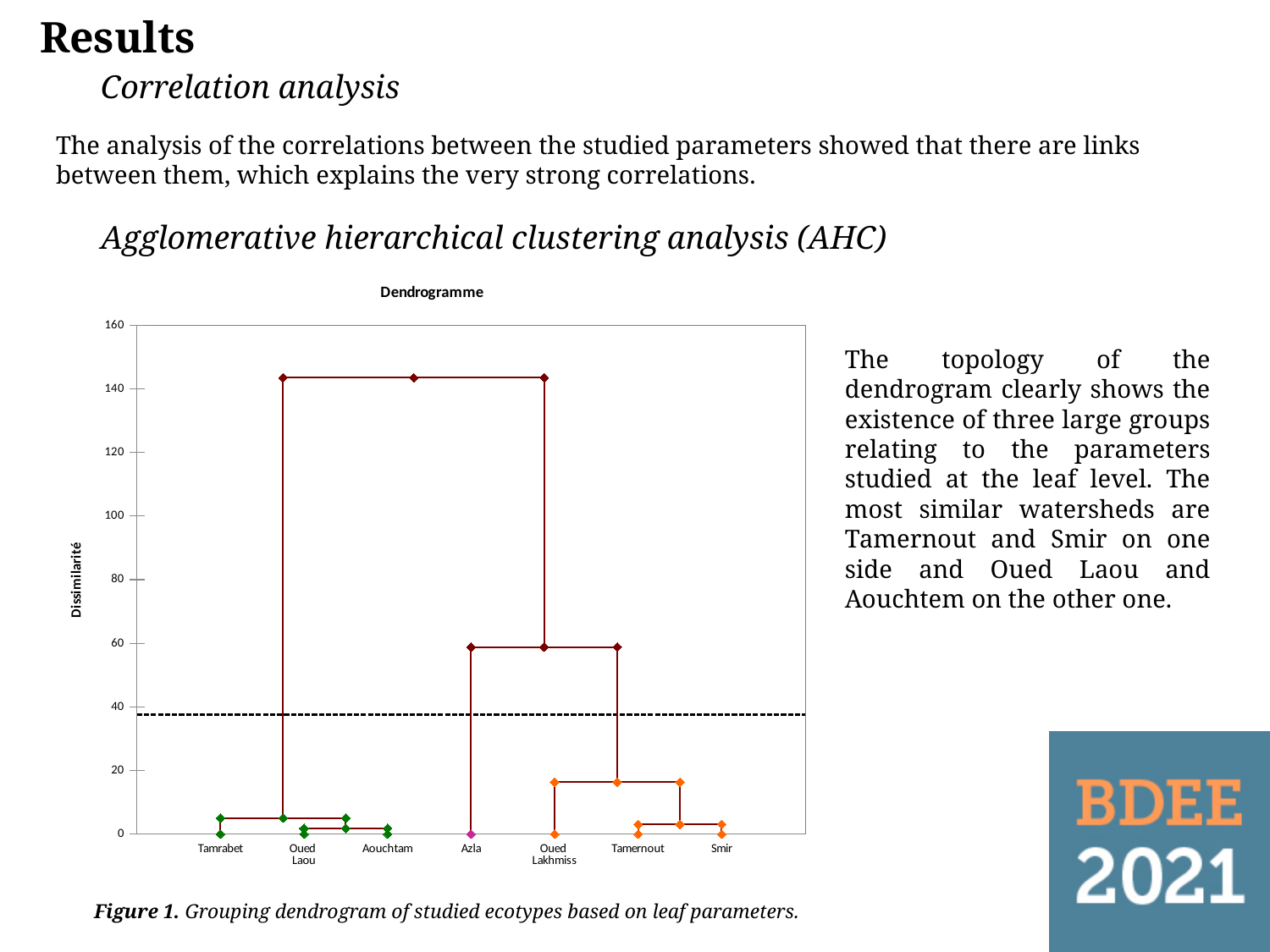
What kind of chart is shown on the slide? Dendrogram Which category label appears first (leftmost) on the x axis of the dendrogram? Tamrabet Is the dissimilarity at which Oued Laou and Aouchtam are joined greater or less than 20? less Which is larger: the dissimilarity at which Azla joins the Oued Lakhmiss/Tamernout/Smir group, or the dissimilarity at which Tamernout and Smir are joined? Azla joining the Oued Lakhmiss/Tamernout/Smir group Is the dissimilarity at which the top-level merge (joining the Tamrabet/Oued Laou/Aouchtam group with the rest) occurs greater or less than 140? greater Is the dissimilarity at which Oued Lakhmiss joins the Tamernout/Smir pair greater or less than 40? less How many ecotypes (categories) are labelled along the x axis of the dendrogram? 7 What is the title printed above the dendrogram? Dendrogramme What is the maximum value shown on the y axis of the dendrogram? 160 What is the label of the y axis of the dendrogram? Dissimilarité